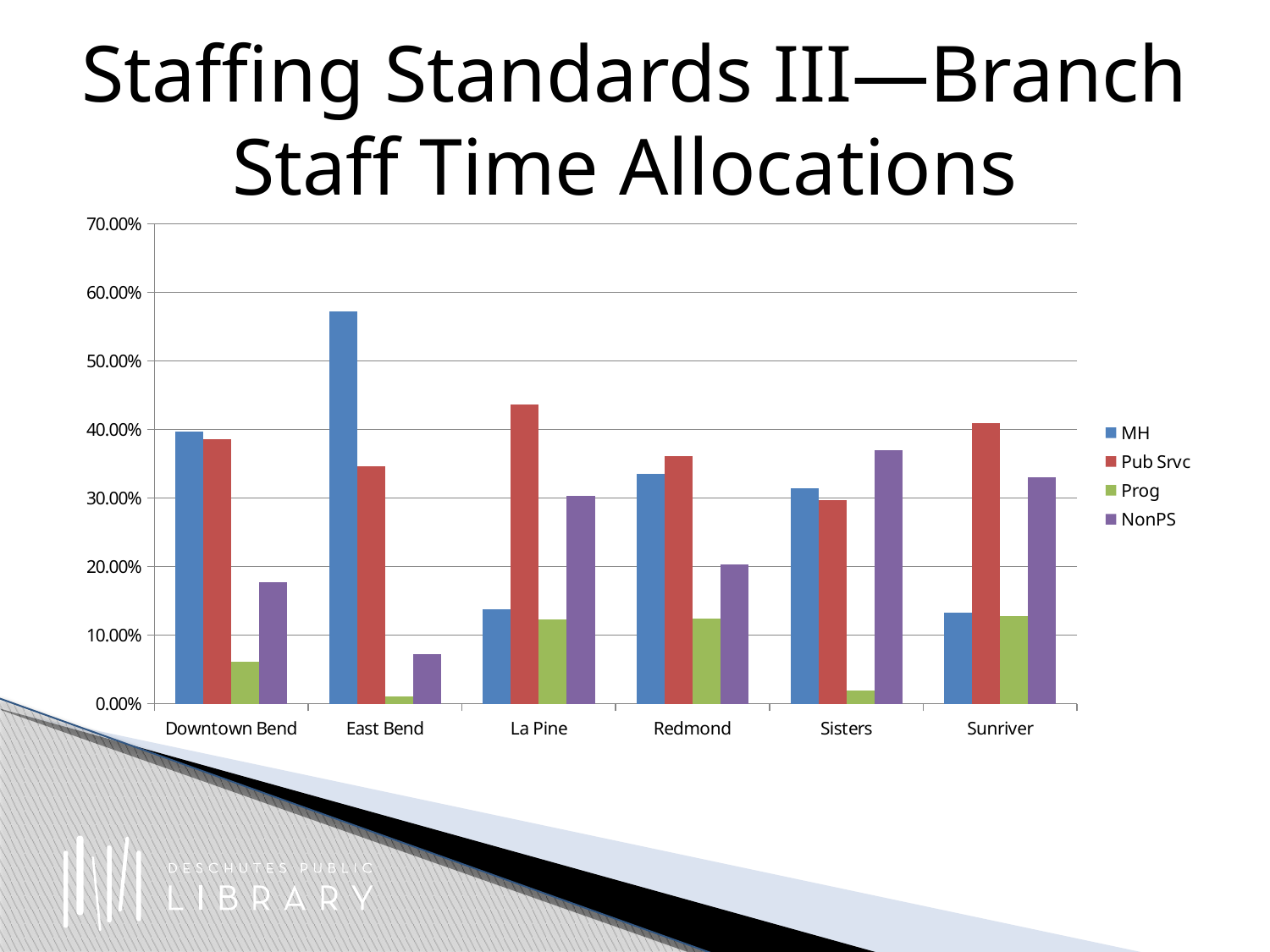
Is the MH value for East Bend greater or less than 50.00%? greater For Sisters, which is larger: the NonPS value or the Pub Srvc value? NonPS Which branch has the highest NonPS value? Sisters How many series does the chart's legend list? 4 How many branches are shown on the x axis of the chart? 6 Which branch has the highest MH value? East Bend Which branch has the highest Pub Srvc value? La Pine For Downtown Bend, which is larger: the MH value or the Prog value? MH What are the four series listed in the chart's legend? MH, Pub Srvc, Prog, NonPS Is the MH value for Sunriver greater or less than 20.00%? less What kind of chart is shown on the slide? bar chart Is the Pub Srvc value for La Pine greater or less than 40.00%? greater